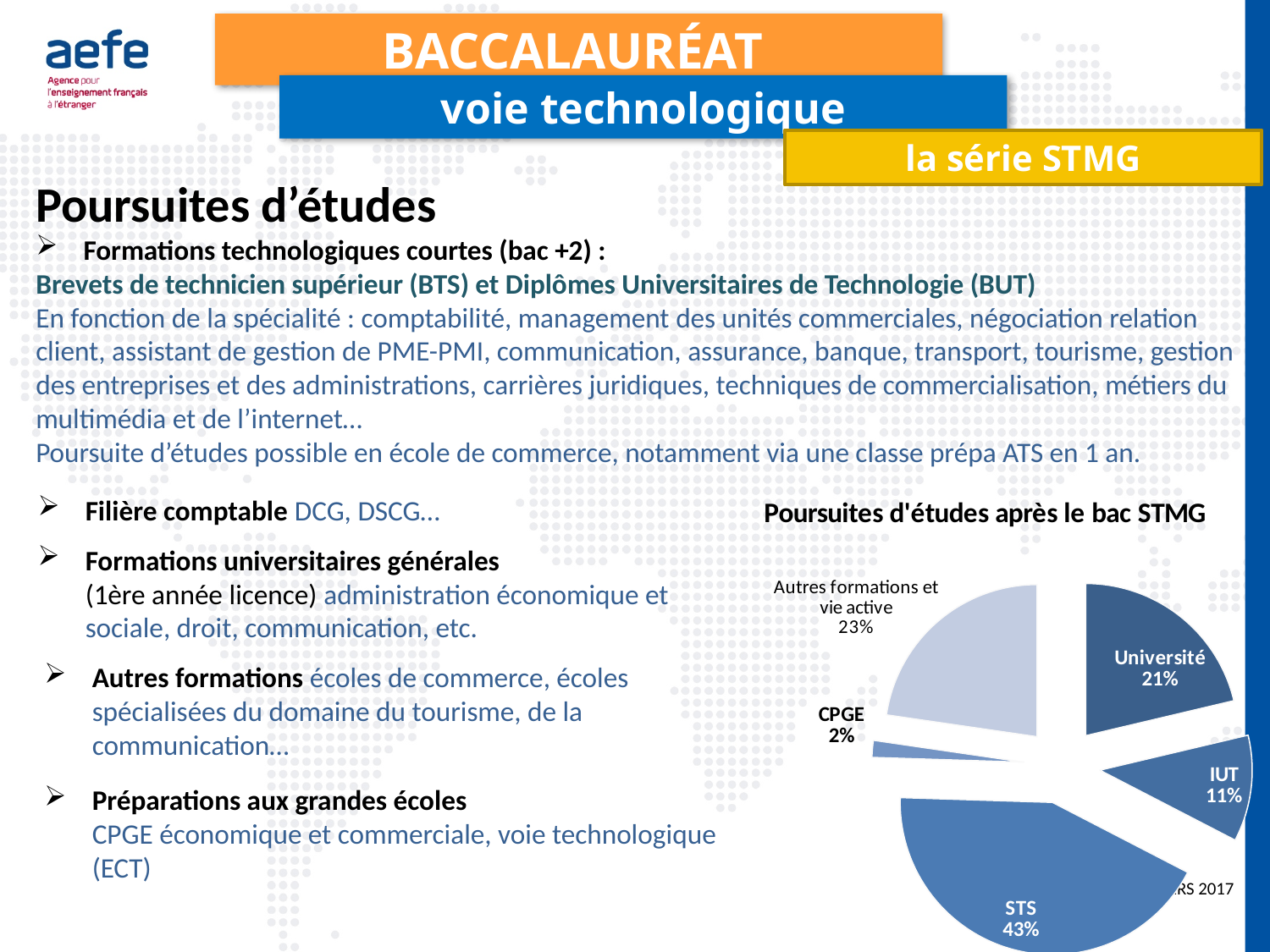
What is the title of the chart? Poursuites d'études après le bac STMG What share of the pie does STS represent? 43% What is the difference between the STS share and the Université share? 22% How many slices does the pie chart have? 5 What is the value shown for IUT? 11% Which category has the largest slice of the pie? STS Which category has the smallest slice of the pie? CPGE What is the value shown for Autres formations et vie active? 23% Which is larger, the share for IUT or the share for Université? Université What kind of chart is shown on the slide? pie chart What is the value shown for CPGE? 2% What is the value shown for Université? 21%